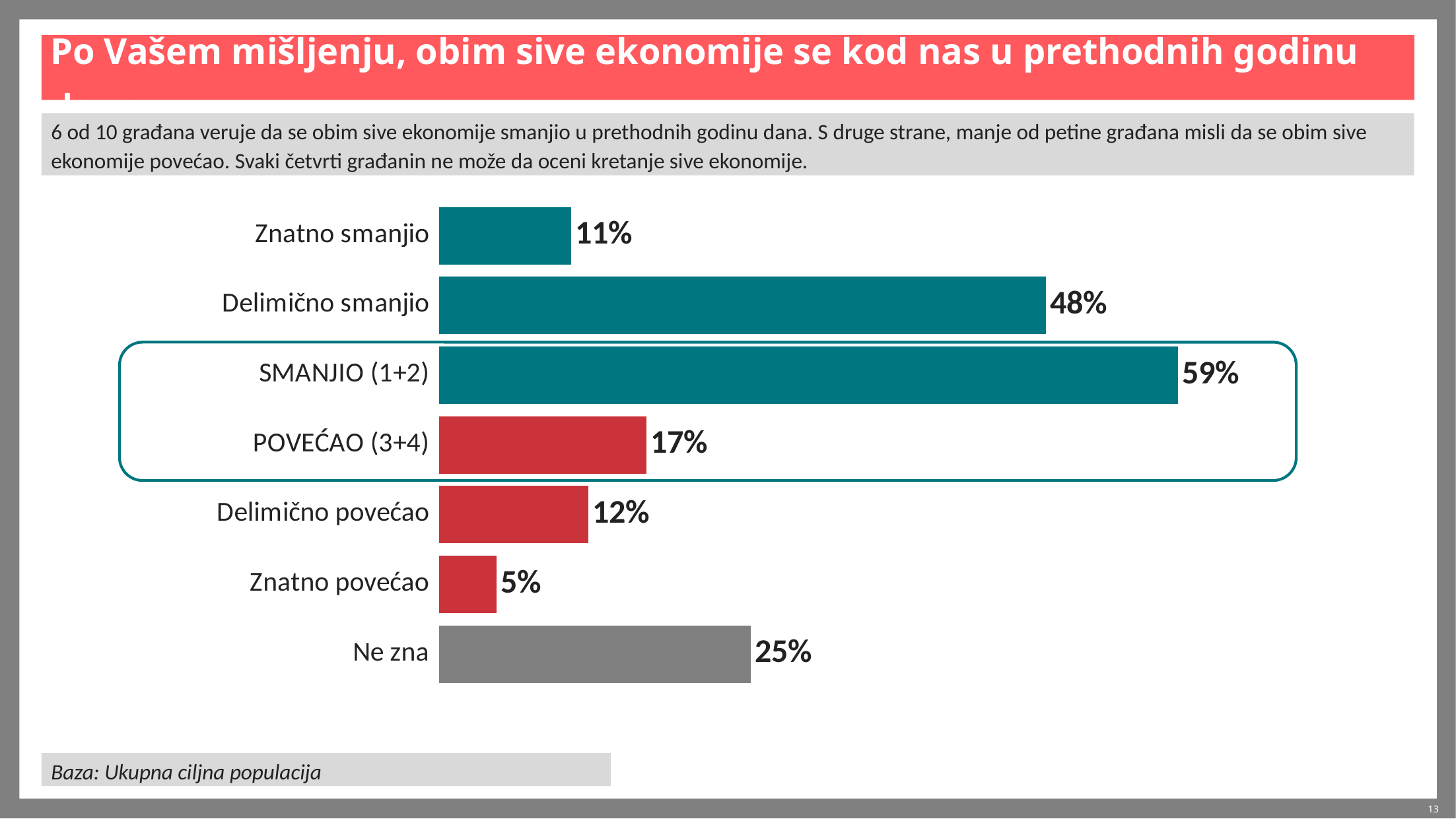
What is the difference between Delimično povećao and Znatno smanjio? 1% Which is larger, Ne zna or POVEĆAO (3+4)? Ne zna Which category has the lowest value? Znatno povećao What is the value for Delimično smanjio? 48% What is the value for Znatno povećao? 5% How many categories are shown in the chart? 7 What kind of chart is shown on the slide? bar chart What is the difference between SMANJIO (1+2) and POVEĆAO (3+4)? 42% Which category has the highest value? SMANJIO (1+2) What is the value for Ne zna? 25% What is the value for POVEĆAO (3+4)? 17% What colour are the bars for Delimično povećao and Znatno povećao? red